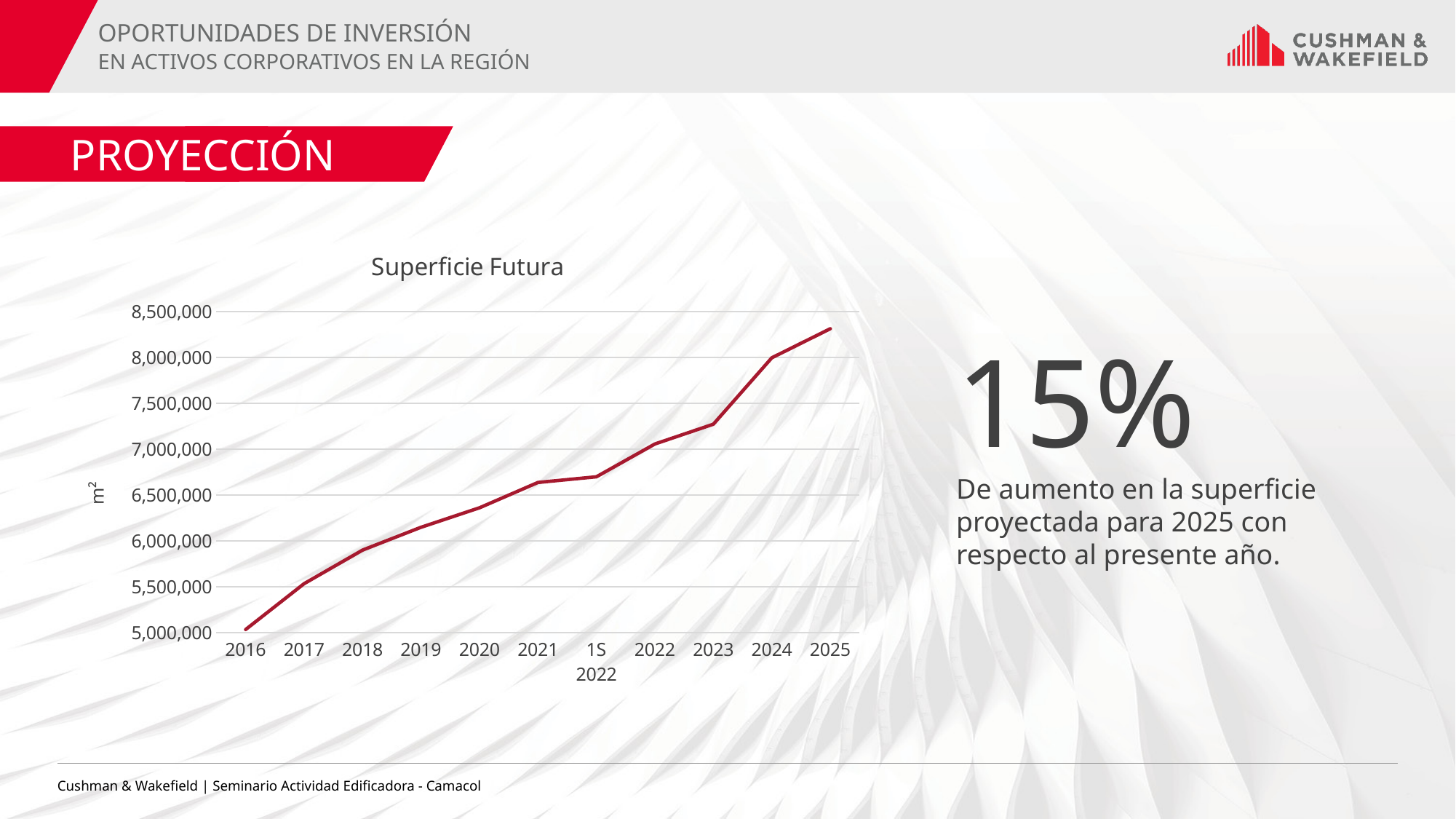
What type of chart is shown on the slide? line chart What is the title of the chart? Superficie Futura Which year has the lowest value in the chart? 2016 Which year has the highest value in the chart? 2025 Is the value for 2023 greater or less than 7,500,000? less Is the value for 2025 greater or less than 8,000,000? greater Do the values rise or fall from 2016 to 2025? rise How many points are plotted along the x axis of the chart? 11 What unit is shown on the vertical axis of the chart? m² Which is larger, the value for 2024 or the value for 2021? 2024 Is the value for 2020 greater or less than 6,500,000? less